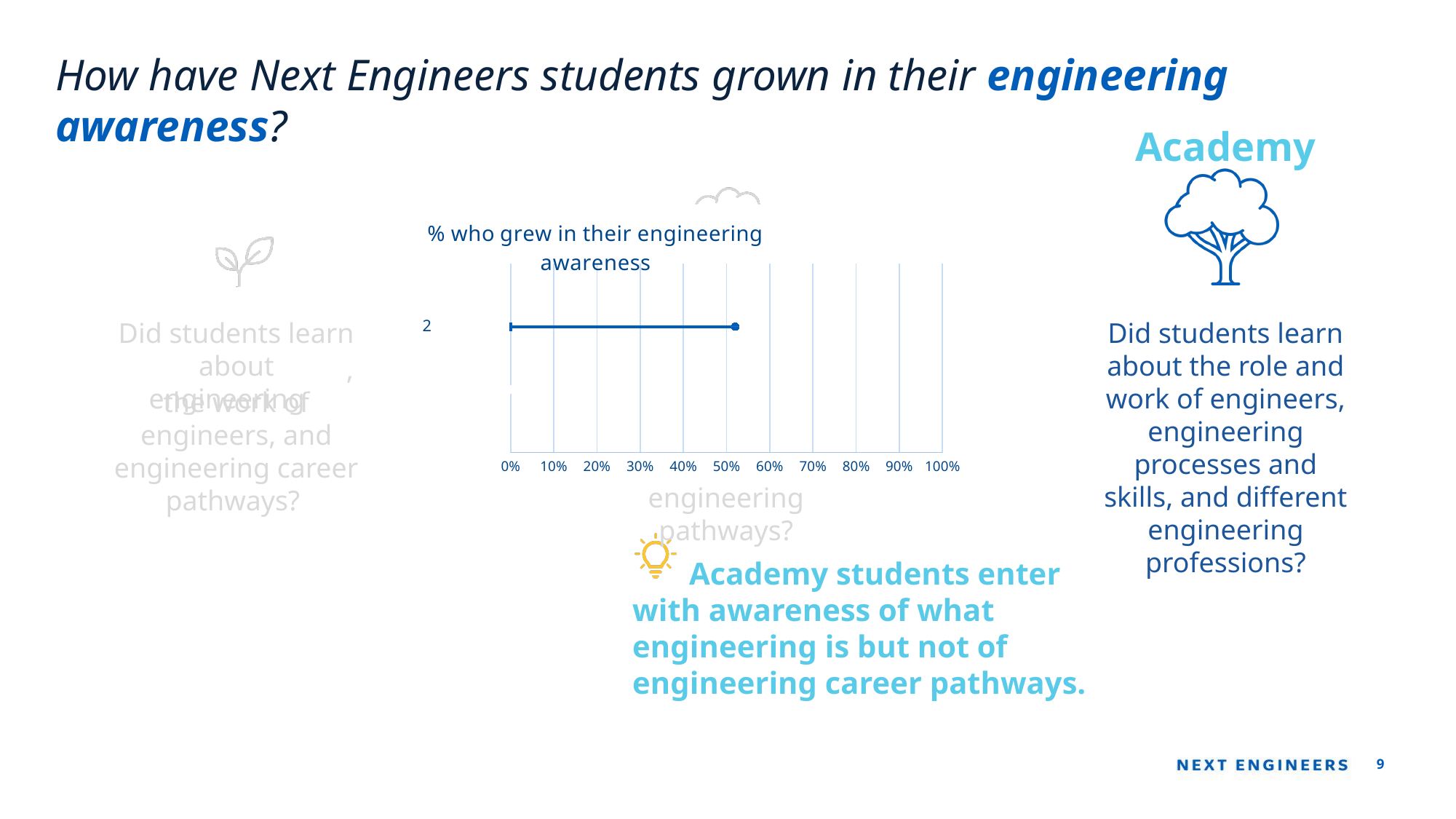
What is the lowest value shown on the chart's x axis? 0% Is the value for category 2 greater or less than 60%? less What kind of chart is shown on the slide? line chart What is the title of the chart? % who grew in their engineering awareness Is the value for category 2 greater or less than 40%? greater How many categories are plotted in the chart? 1 What is the label of the single category plotted in the chart? 2 Is the value for category 2 greater or less than 30%? greater What is the highest value shown on the chart's x axis? 100%